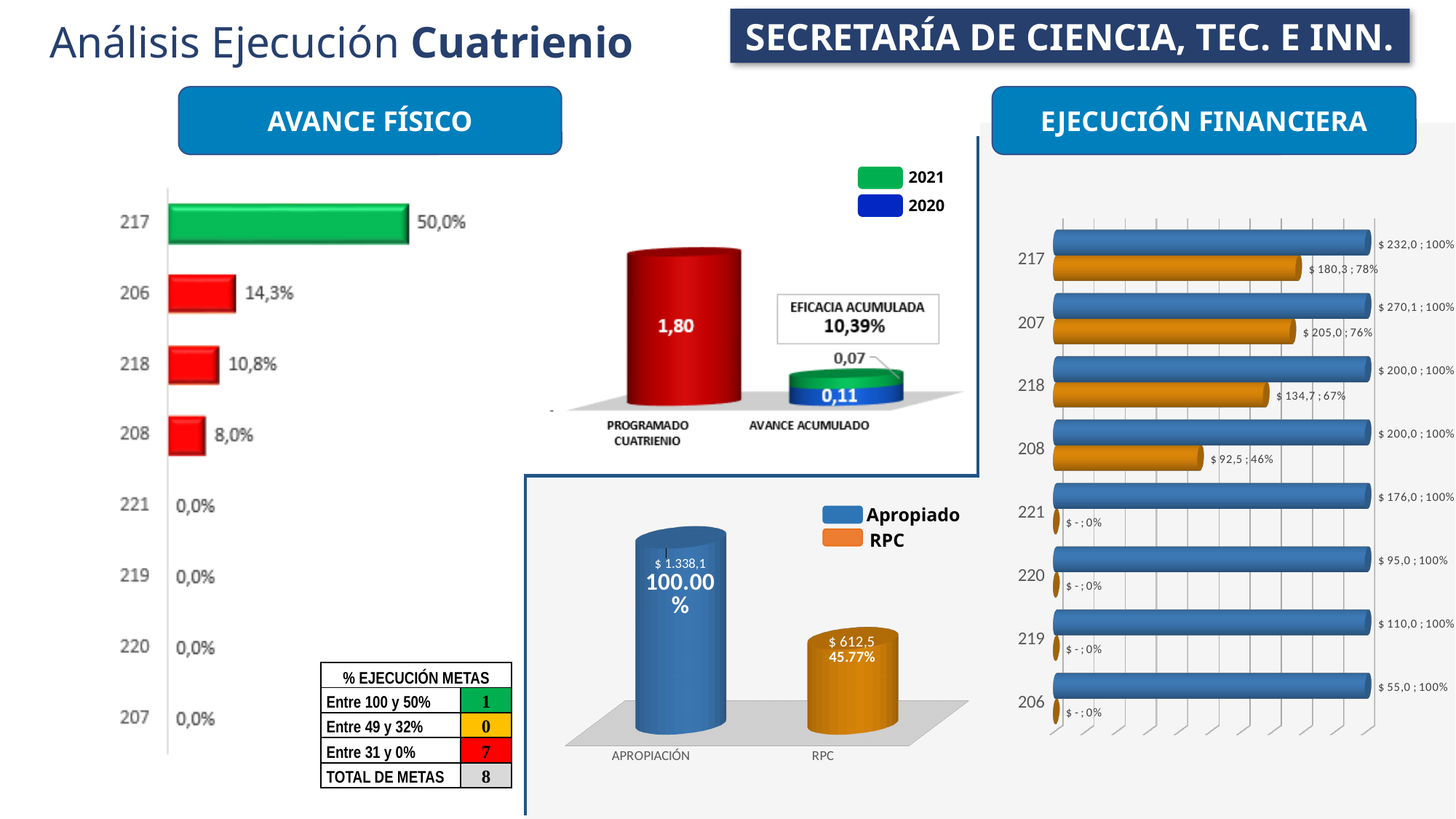
In the PROGRAMADO CUATRIENIO vs AVANCE ACUMULADO chart in the middle, what is the 2021 value for AVANCE ACUMULADO? 0,07 In the EJECUCIÓN FINANCIERA chart on the right, what is the RPC percentage for category 208? 46% In the PROGRAMADO CUATRIENIO vs AVANCE ACUMULADO chart in the middle, what is the value for PROGRAMADO CUATRIENIO? 1,80 In the AVANCE FÍSICO bar chart on the left, how many categories have a value of 0,0%? 4 In the PROGRAMADO CUATRIENIO vs AVANCE ACUMULADO chart in the middle, how many series does the legend list? 2 In the APROPIACIÓN vs RPC chart at the bottom middle, what is the value for RPC? $ 612,5 In the AVANCE FÍSICO bar chart on the left, what is the value for category 217? 50,0% In the EJECUCIÓN FINANCIERA chart on the right, what is the Apropiado value for category 207? $ 270,1 In the APROPIACIÓN vs RPC chart at the bottom middle, what percentage is shown for RPC? 45.77% In the AVANCE FÍSICO bar chart on the left, which category has the highest value? 217 In the AVANCE FÍSICO bar chart on the left, what is the difference between the values for 206 and 218? 3,5% In the AVANCE FÍSICO bar chart on the left, how many categories are shown? 8